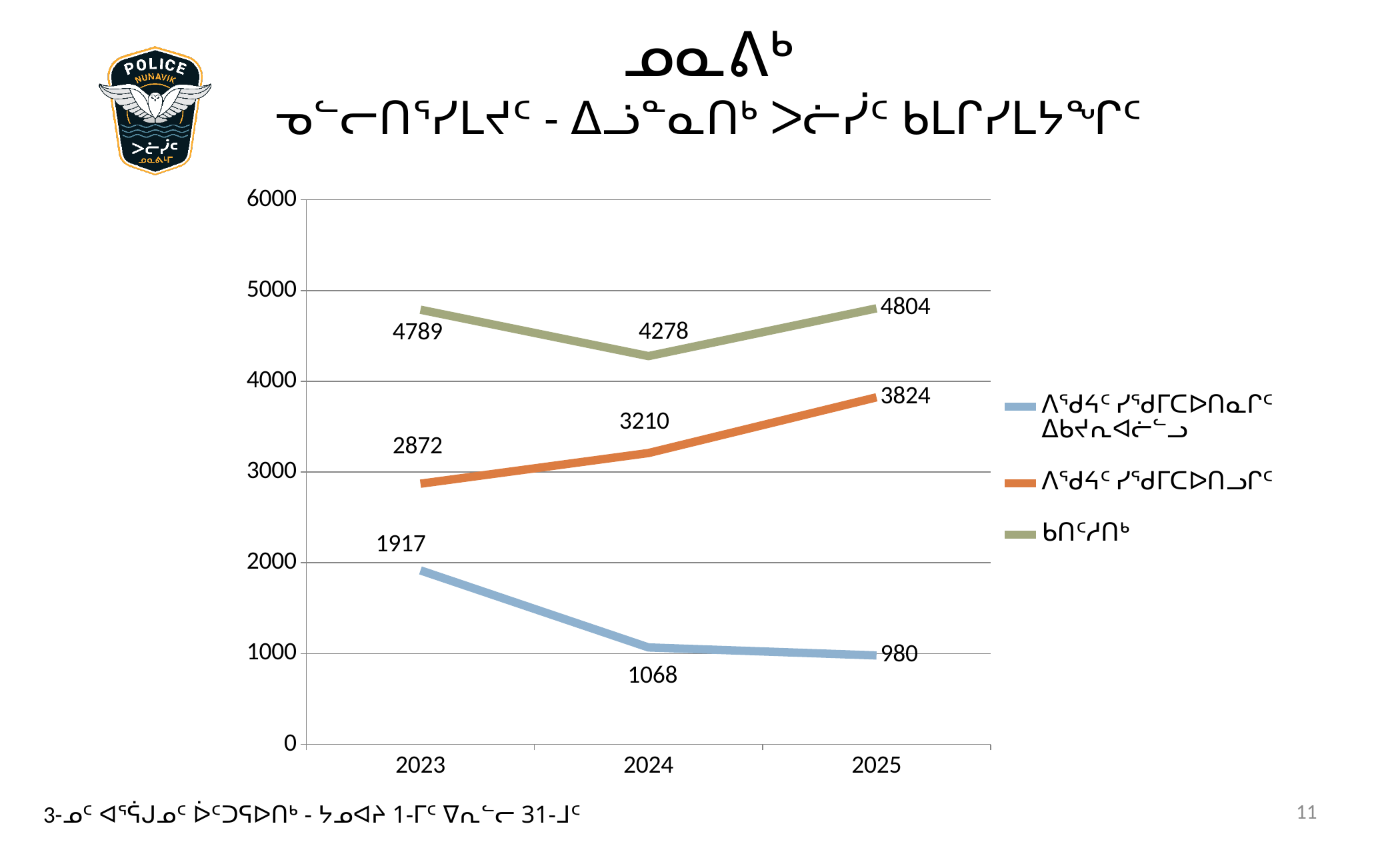
What is the difference between the green line's values in 2023 and 2024? 511 What is the value of the green line in 2024? 4278 In which year does the green line reach its highest value? 2025 What kind of chart is shown on the slide? line chart What is the value of the orange line in 2025? 3824 In which year does the blue line have its lowest value? 2025 What is the value of the blue line in 2023? 1917 In 2023, which line has the larger value, the green line or the orange line? green line Does the orange line rise or fall from 2023 to 2025? rise How many series does the legend list? 3 By how much did the orange line increase from 2023 to 2025? 952 How many years are shown on the x axis? 3